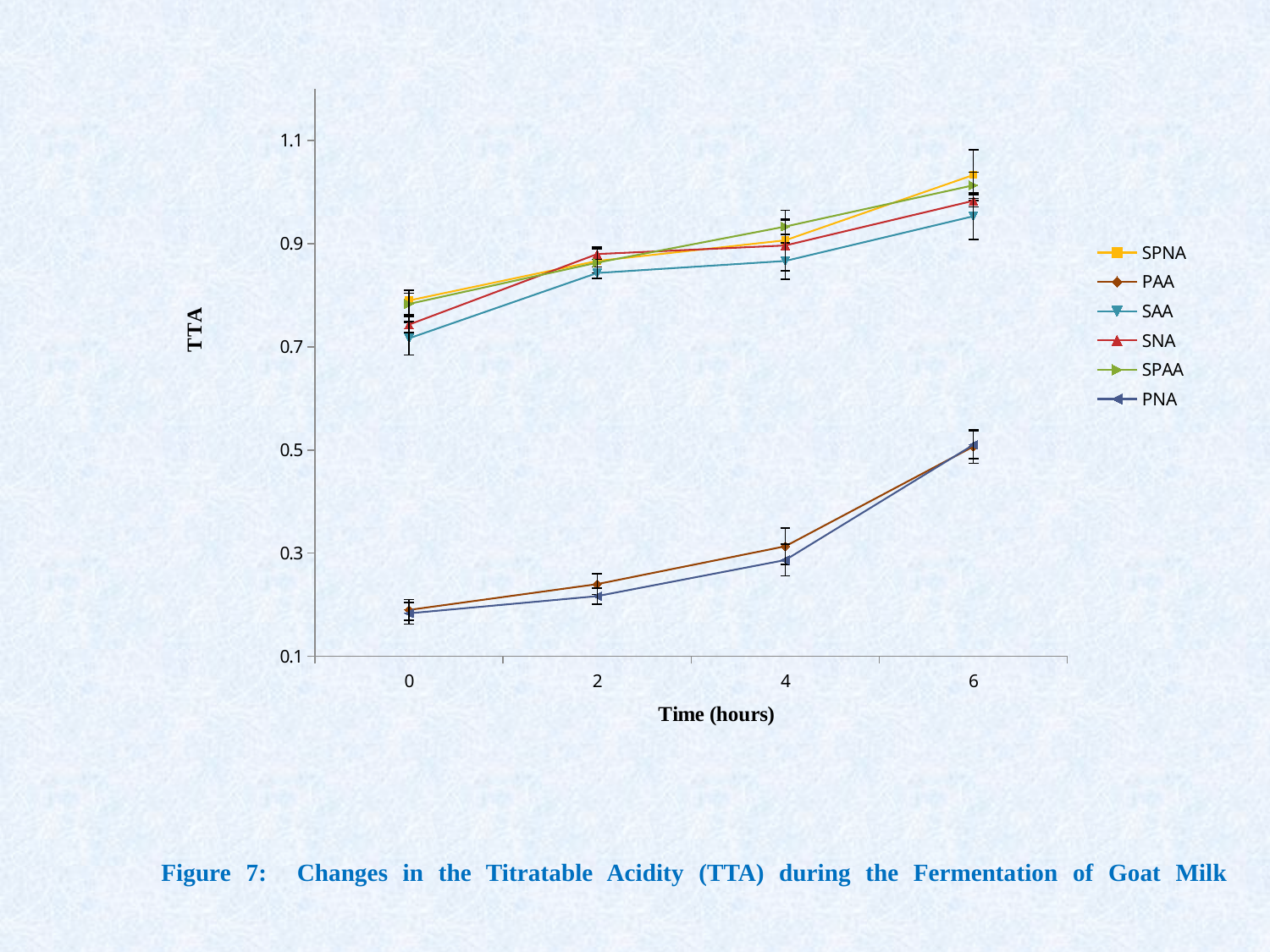
What kind of chart is shown on the slide? line chart Is the value for PNA at 6 hours greater or less than 0.7? less Is the value for SAA at 0 hours greater or less than 0.9? less How many series does the legend list? 6 Does the SPNA series rise or fall as time increases from 0 to 6 hours? rise At 0 hours, which series has the larger value, SAA or PAA? SAA How many time points are plotted along the x axis? 4 At 4 hours, which series has the larger value, SPNA or PNA? SPNA Is the value for PAA at 2 hours greater or less than 0.5? less What is the title of the x axis? Time (hours) Does the PNA series rise or fall as time increases from 0 to 6 hours? rise